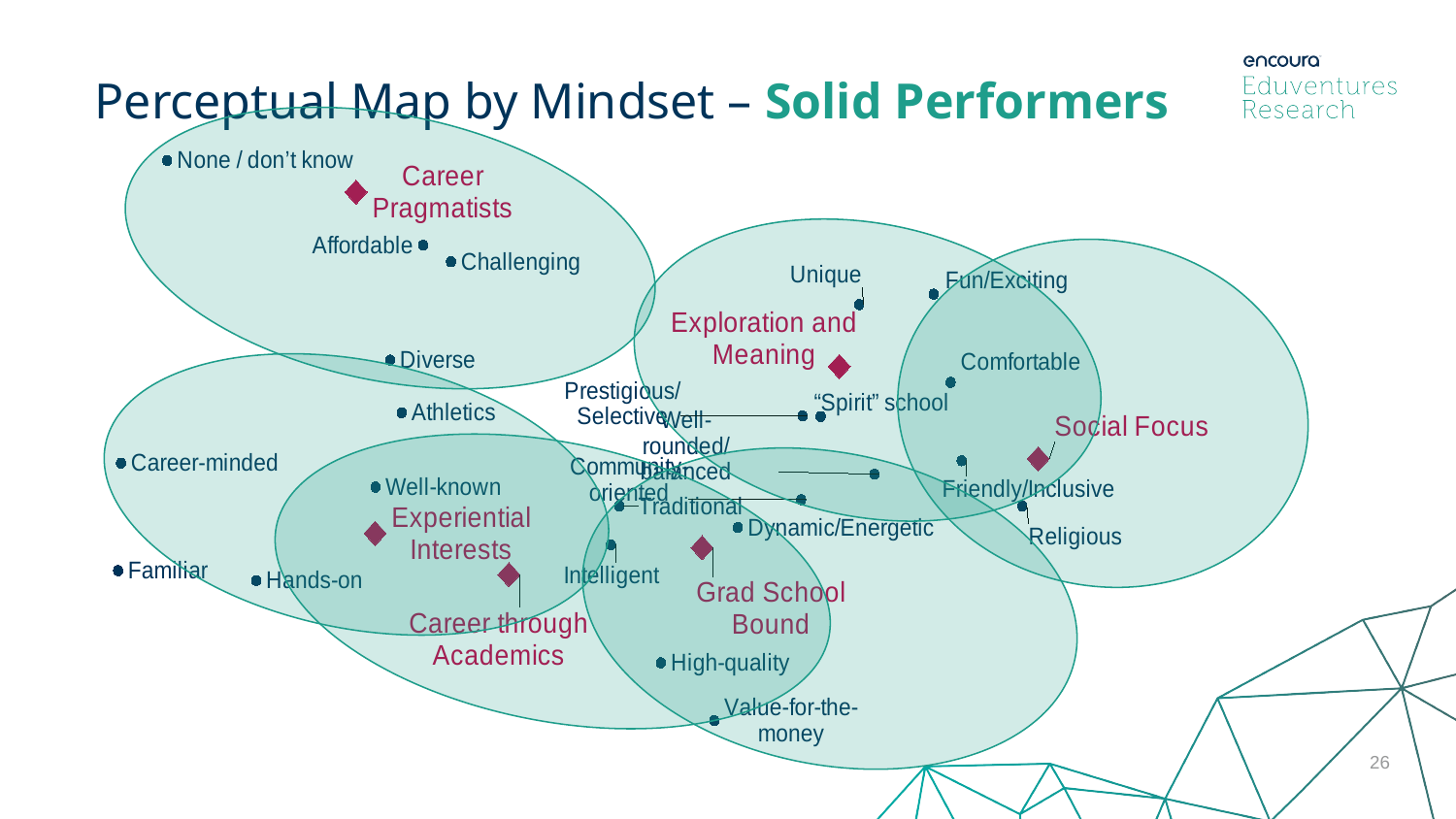
Which mindset segment is plotted closest to the attributes Comfortable and Friendly/Inclusive? Social Focus What kind of chart is shown on the slide? Scatter plot (perceptual map) Which attribute is plotted lowest on the map? Value-for-the-money Which attribute appears in the top-left corner of the map, above Career Pragmatists? None / don't know Which attribute is plotted furthest to the left on the map? Familiar Which mindset segment is plotted closest to the attributes Unique and "Spirit" school? Exploration and Meaning What is the title of the chart? Perceptual Map by Mindset – Solid Performers How many mindset segments (diamond markers) are plotted on the perceptual map? 6 Which mindset segment is plotted closest to the attribute Hands-on? Experiential Interests Which mindset segment is plotted in the top-left ellipse of the map? Career Pragmatists Which mindset segment is plotted closest to the attribute High-quality? Grad School Bound Which mindset segment is plotted furthest to the right on the map? Social Focus